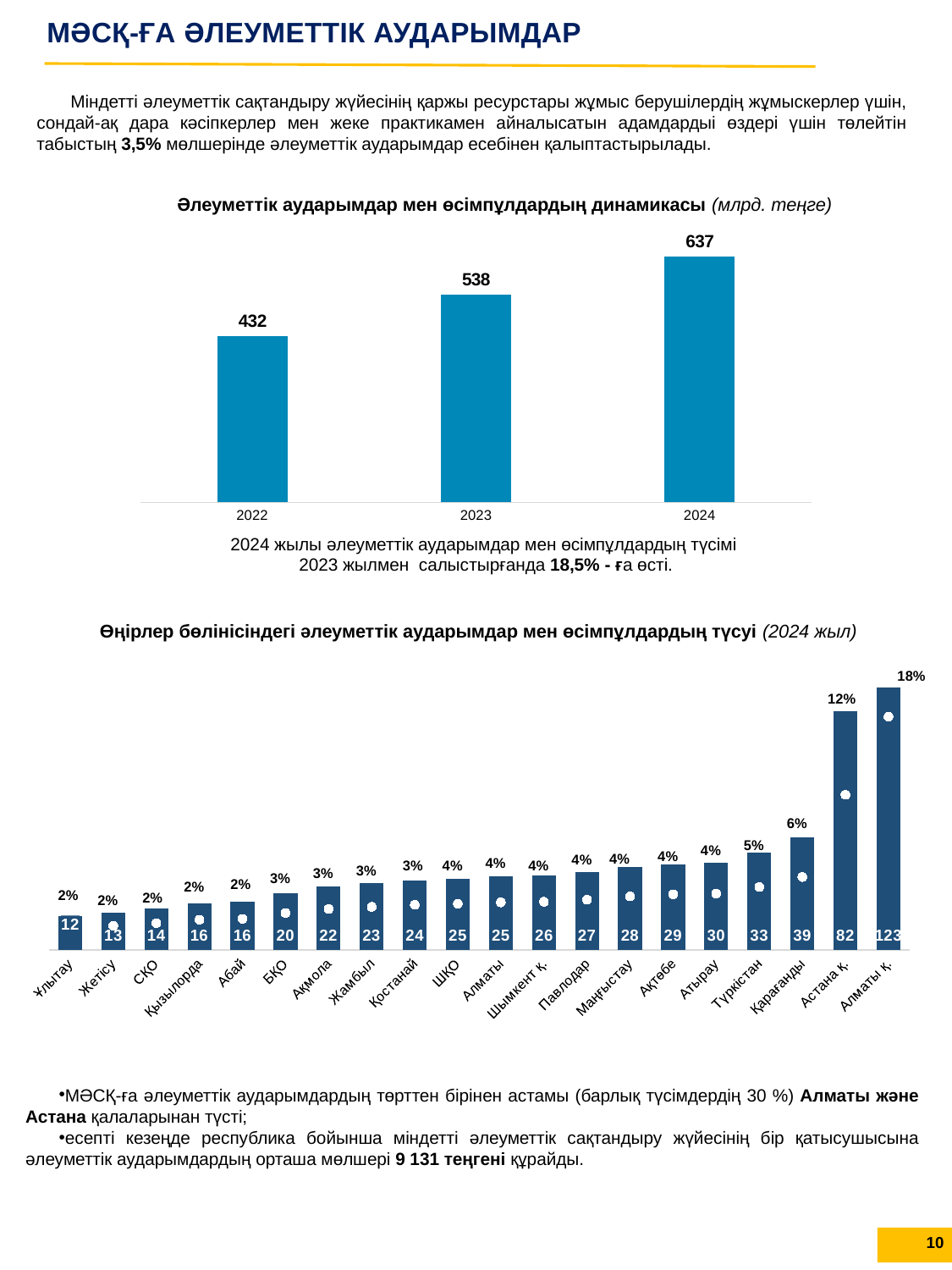
In the bottom chart (Өңірлер бөлінісіндегі әлеуметтік аударымдар мен өсімпұлдардың түсуі), which is larger: the value for Түркістан or the value for Атырау? Түркістан In the top chart (Әлеуметтік аударымдар мен өсімпұлдардың динамикасы), what is the difference between the 2024 and 2023 values? 99 In the bottom chart (Өңірлер бөлінісіндегі әлеуметтік аударымдар мен өсімпұлдардың түсуі), which region has the lowest value? Ұлытау In the top chart (Әлеуметтік аударымдар мен өсімпұлдардың динамикасы), what is the value for 2024? 637 In the top chart (Әлеуметтік аударымдар мен өсімпұлдардың динамикасы), what is the value for 2022? 432 In the top chart (Әлеуметтік аударымдар мен өсімпұлдардың динамикасы), do the values rise or fall from 2022 to 2024? rise In the top chart (Әлеуметтік аударымдар мен өсімпұлдардың динамикасы), how many years are shown? 3 In the bottom chart (Өңірлер бөлінісіндегі әлеуметтік аударымдар мен өсімпұлдардың түсуі), what is the value for Астана қ.? 82 In the bottom chart (Өңірлер бөлінісіндегі әлеуметтік аударымдар мен өсімпұлдардың түсуі), how many regions are shown? 20 In the bottom chart (Өңірлер бөлінісіндегі әлеуметтік аударымдар мен өсімпұлдардың түсуі), what percentage share is shown for Қарағанды? 6% In the bottom chart (Өңірлер бөлінісіндегі әлеуметтік аударымдар мен өсімпұлдардың түсуі), which region has the highest value? Алматы қ. What type of chart is the top chart (Әлеуметтік аударымдар мен өсімпұлдардың динамикасы)? bar chart